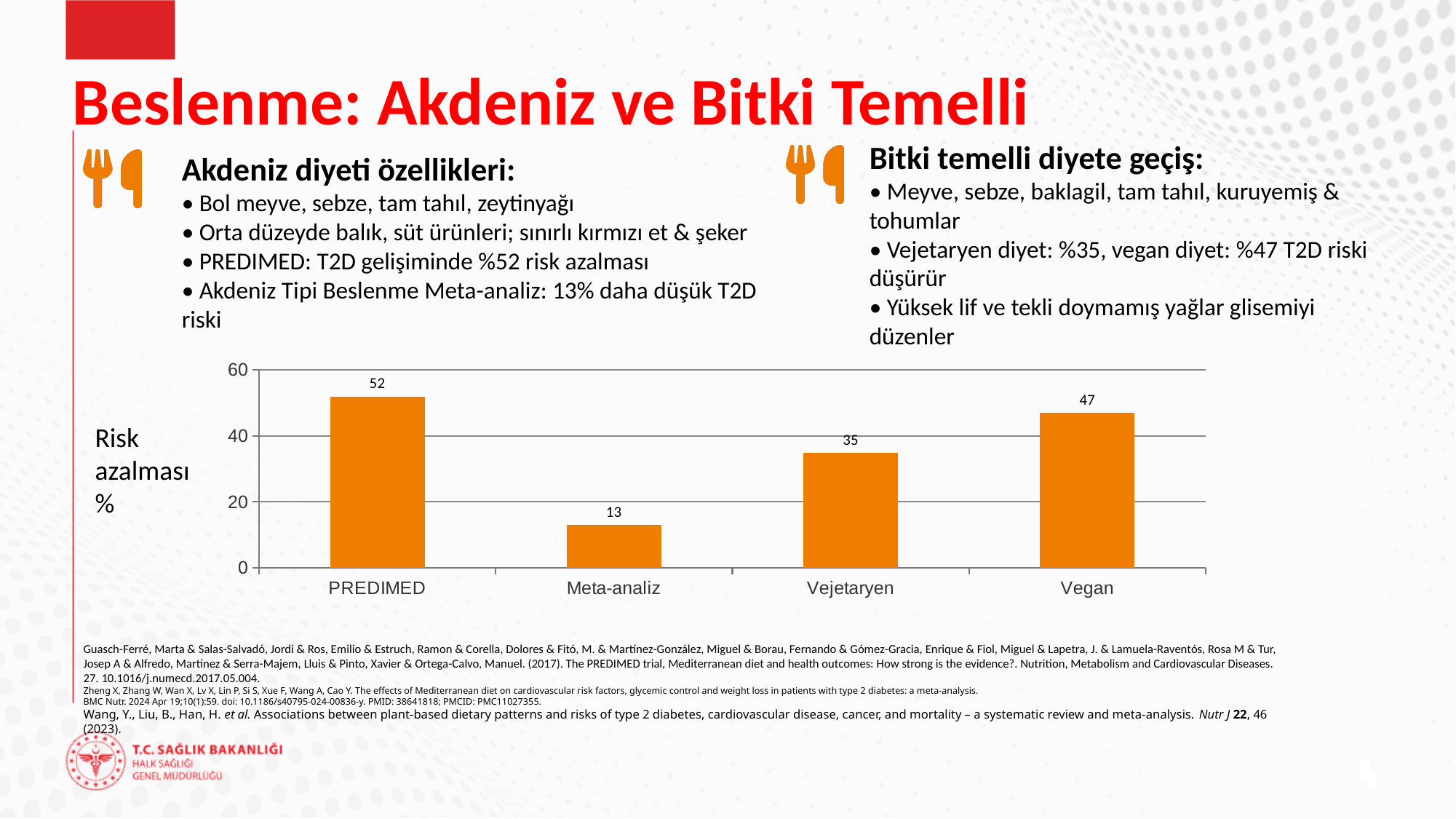
How many categories are shown on the x axis of the chart? 4 Which category has the highest value in the chart? PREDIMED What is the value shown for Vejetaryen? 35 Which is larger, the value for Vejetaryen or the value for Vegan? Vegan Which category has the lowest value in the chart? Meta-analiz What is the value shown for Meta-analiz? 13 What is the difference between the values for Vegan and Vejetaryen? 12 What kind of chart is shown on the slide? bar chart Is the value for Vejetaryen greater or less than 40? less What is the difference between the values for PREDIMED and Meta-analiz? 39 What is the value shown for Vegan? 47 What is the risk reduction value shown for PREDIMED? 52